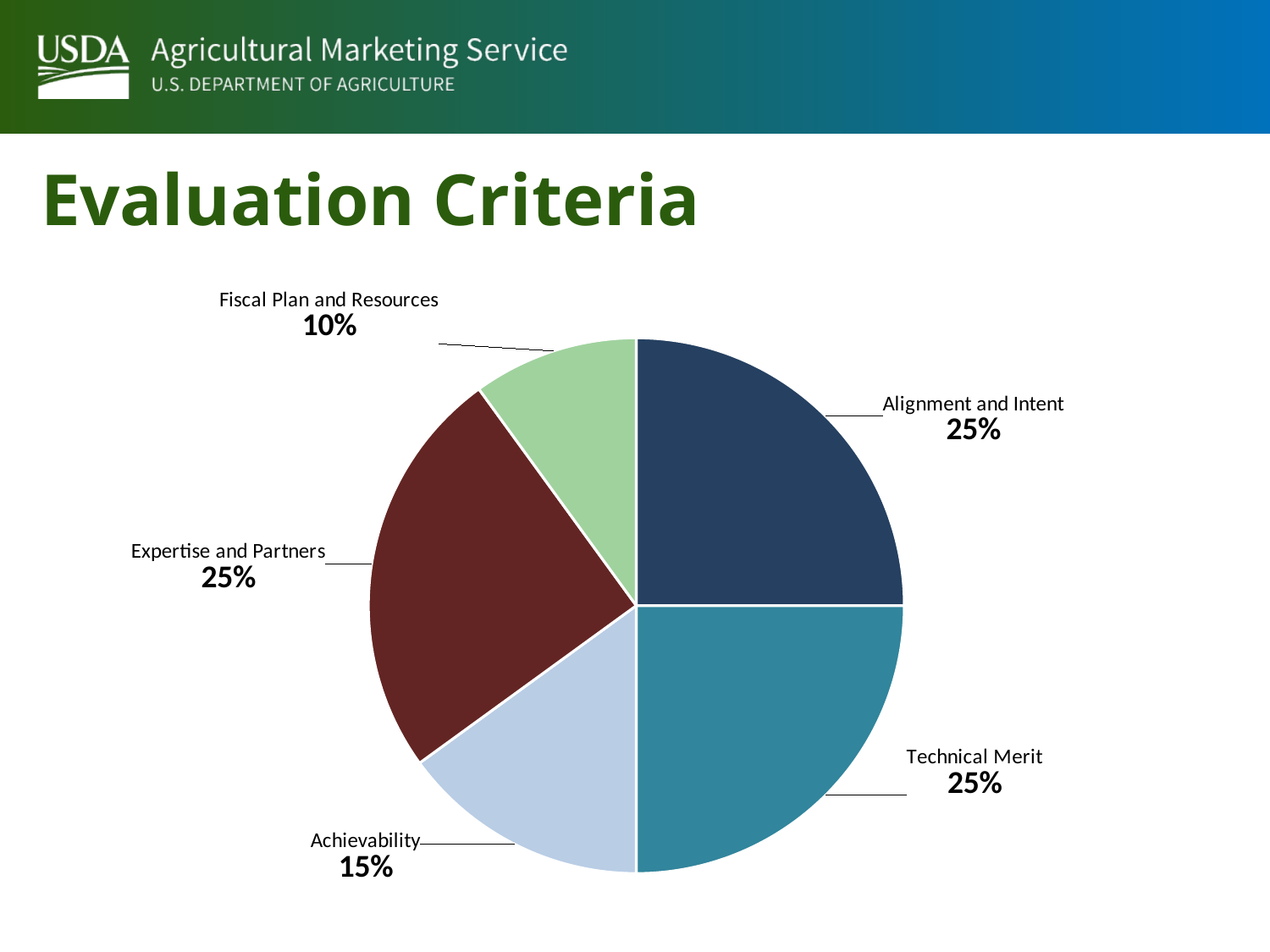
What percentage is shown for Expertise and Partners? 25% What is the title of the slide containing the pie chart? Evaluation Criteria What colour is the Fiscal Plan and Resources slice? light green Which category has the smallest share of the pie? Fiscal Plan and Resources What percentage is shown for Fiscal Plan and Resources? 10% What type of chart is shown on the slide? pie chart What is the difference between the shares for Alignment and Intent and Achievability? 10% How many categories are shown in the pie chart? 5 What percentage is shown for Technical Merit? 25% What is the difference between the shares for Achievability and Fiscal Plan and Resources? 5% What percentage is shown for Achievability? 15% Which is larger, the share for Achievability or the share for Fiscal Plan and Resources? Achievability